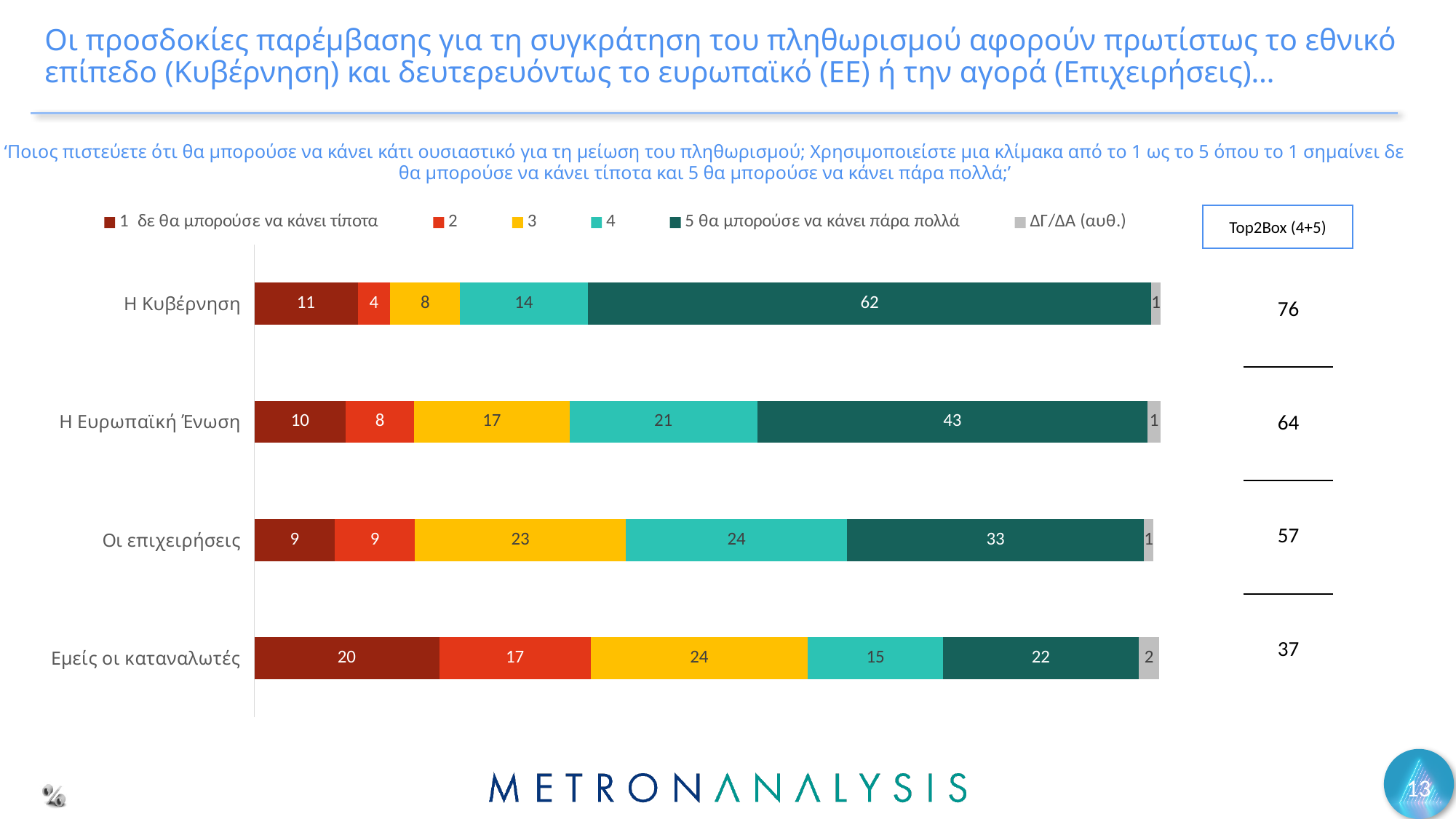
What is the value of the '3' segment for Οι επιχειρήσεις? 23 What is the Top2Box (4+5) value for Η Ευρωπαϊκή Ένωση? 64 How many series does the legend list? 6 How many categories (rows) does the chart show? 4 What is the value of the '1 δε θα μπορούσε να κάνει τίποτα' segment for Εμείς οι καταναλωτές? 20 What is the total of the stacked bar for Η Ευρωπαϊκή Ένωση? 100 What is the difference between the '5 θα μπορούσε να κάνει πάρα πολλά' values for Η Κυβέρνηση and Η Ευρωπαϊκή Ένωση? 19 Which category has the lowest Top2Box (4+5) value? Εμείς οι καταναλωτές What kind of chart is shown on the slide? Stacked bar chart What is the value of the '5 θα μπορούσε να κάνει πάρα πολλά' segment for Η Κυβέρνηση? 62 Which is larger: the '4' value for Οι επιχειρήσεις or the '4' value for Εμείς οι καταναλωτές? Οι επιχειρήσεις Which category has the highest '5 θα μπορούσε να κάνει πάρα πολλά' value? Η Κυβέρνηση